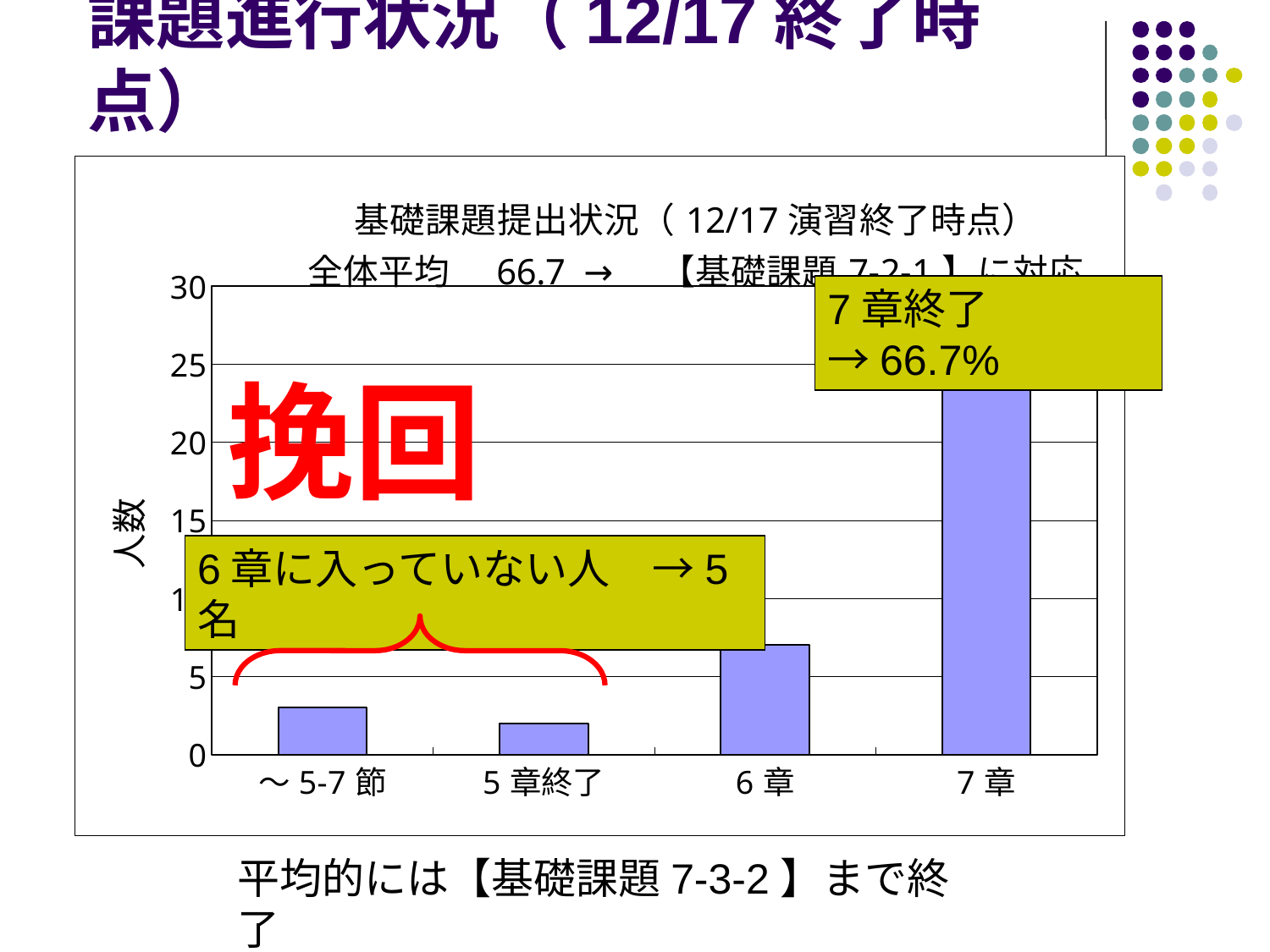
Is the value for ～5-7 節 greater or less than 5? less Which is larger, the value for ～5-7 節 or the value for 5 章終了? ～5-7 節 Is the value for 5 章終了 greater or less than 5? less Is the value for 7 章 greater or less than 20? greater Which category has the lowest bar in the chart? 5 章終了 Which is larger, the value for 6 章 or the value for 5 章終了? 6 章 What is the label of the y axis of the chart? 人数 How many categories are shown on the x axis of the chart? 4 Which category has the highest bar in the chart? 7 章 What kind of chart is shown on the slide? bar chart What is the title of the chart? 基礎課題提出状況（12/17 演習終了時点） 全体平均 66.7 → 【基礎課題 7-2-1】に対応